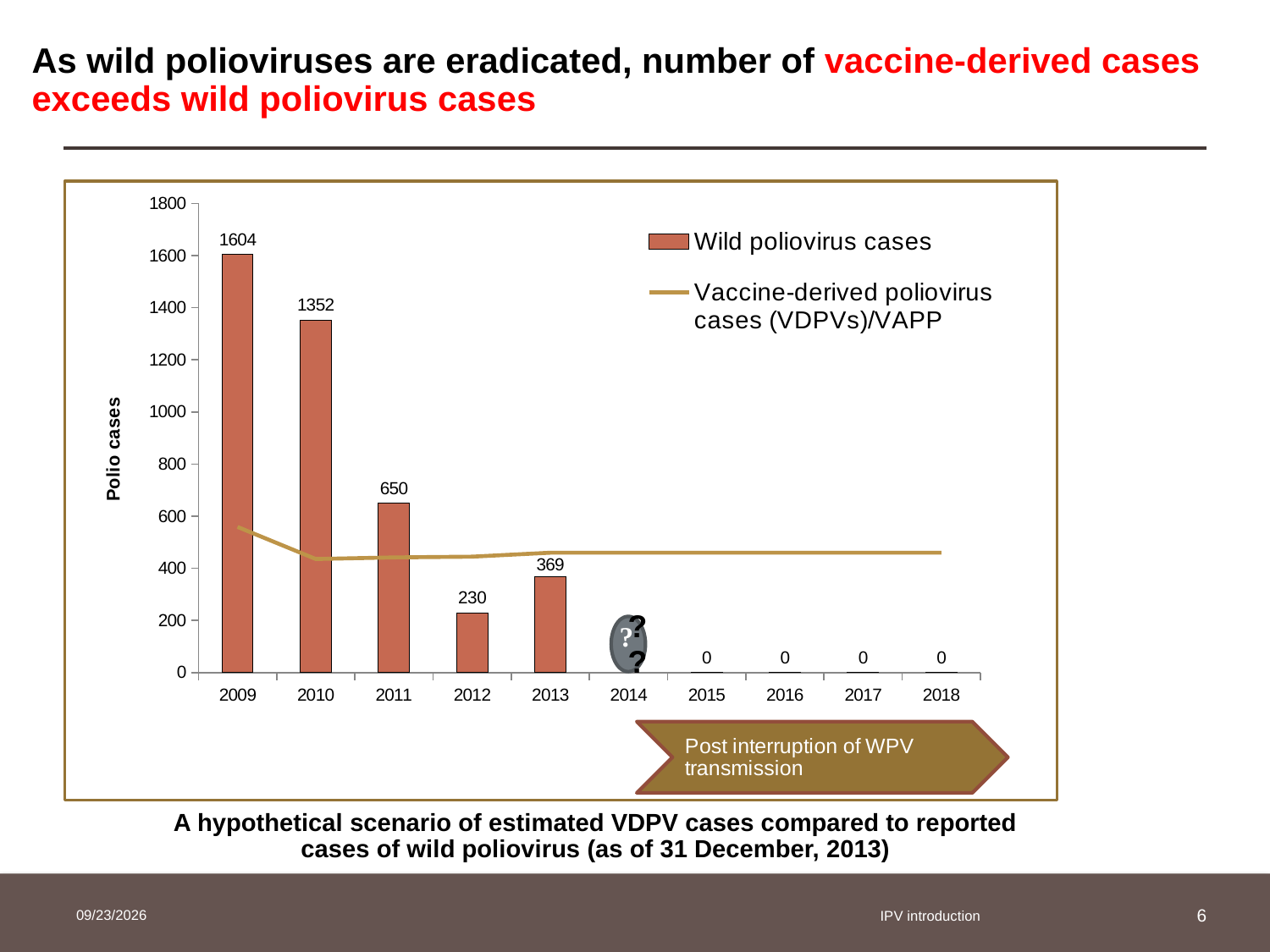
Do the wild poliovirus cases rise or fall from 2009 to 2012? fall How many series does the legend list? 2 What value is shown for wild poliovirus cases in 2017? 0 Among the years 2009 to 2013, which year has the lowest number of wild poliovirus cases? 2012 Is the value of the vaccine-derived poliovirus cases line in 2009 greater or less than 400? greater Which year has more wild poliovirus cases, 2012 or 2013? 2013 How many years are shown on the x axis? 10 How many wild poliovirus cases are shown for 2009? 1604 How many wild poliovirus cases are shown for 2013? 369 What is the value of wild poliovirus cases in 2011? 650 Which year has the highest number of wild poliovirus cases? 2009 What is the difference in wild poliovirus cases between 2009 and 2010? 252